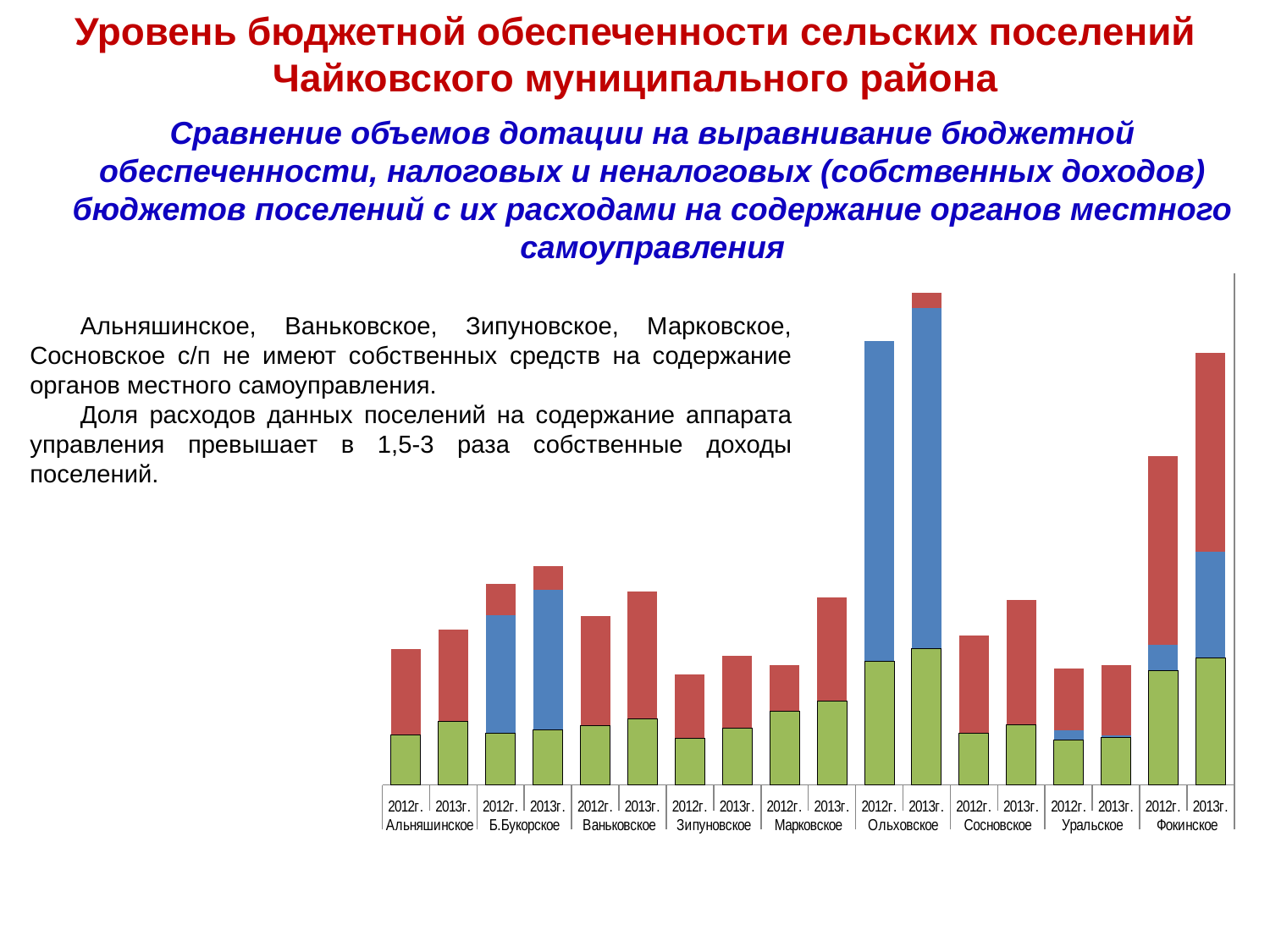
What colour is the bottom segment of each stacked bar? green How many colour segments make up each stacked bar? 3 Which settlement has the two tallest bars in the chart? Ольховское Which bar is the tallest in the chart? Ольховское 2013г. Which years are compared for each settlement in the chart? 2012г. and 2013г. What kind of chart is shown on the slide? stacked bar chart Which bar is taller: Фокинское 2012г. or Фокинское 2013г.? Фокинское 2013г. Which bar is taller: Ольховское 2012г. or Ольховское 2013г.? Ольховское 2013г. How many settlements are shown along the x axis of the chart? 9 Which bar is taller: Б.Букорское 2013г. or Ваньковское 2013г.? Б.Букорское 2013г. How many bars are plotted in the chart? 18